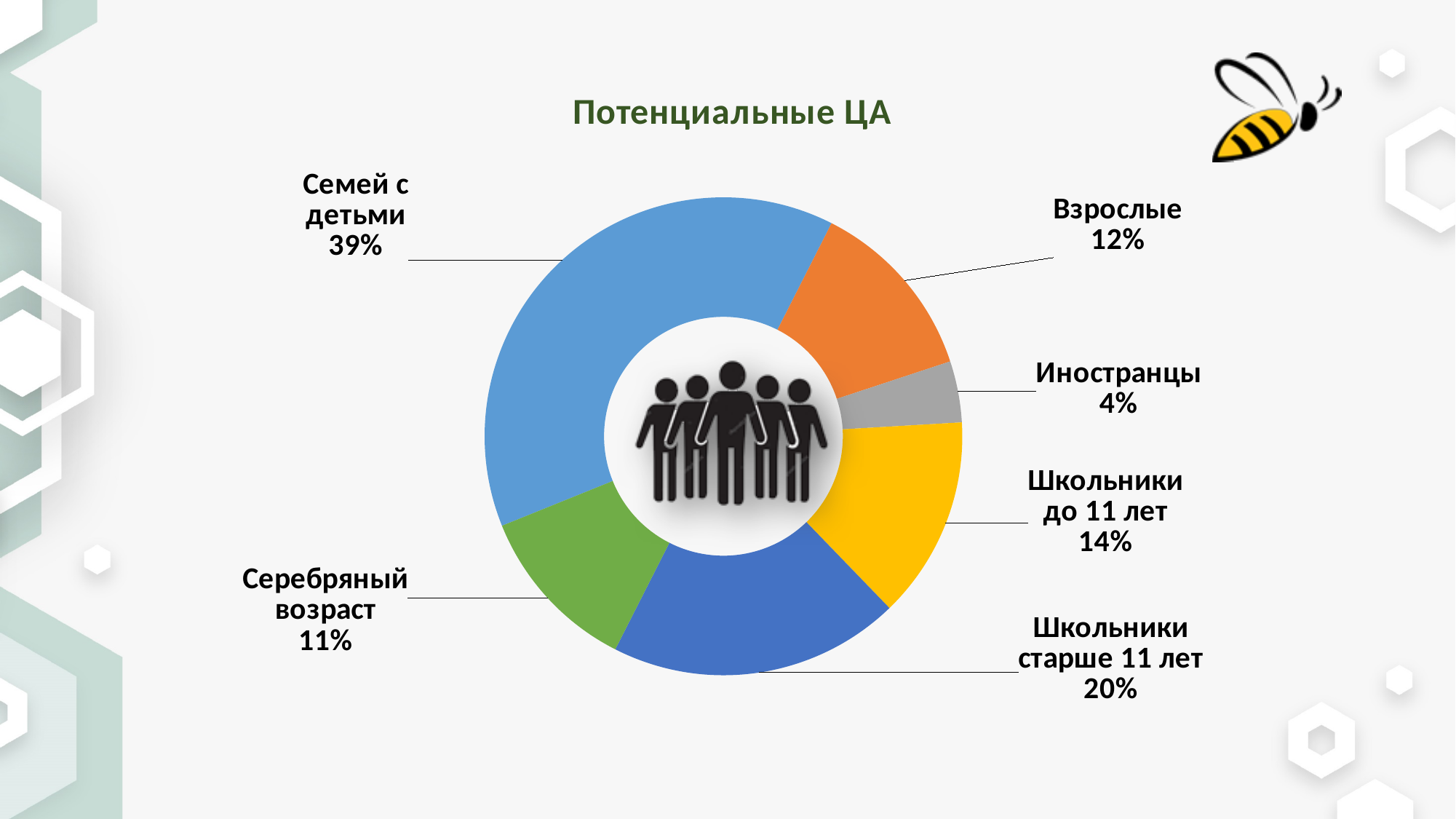
What kind of chart is shown on the slide? Doughnut (pie) chart Which category has the smallest share? Иностранцы Which category has the largest share? Семей с детьми What colour is the 'Школьники до 11 лет' slice? Yellow What share of the chart is 'Серебряный возраст'? 11% What share of the chart is 'Семей с детьми'? 39% How many categories does the chart show? 6 What is the difference in percentage points between 'Семей с детьми' and 'Школьники старше 11 лет'? 19 What share of the chart is 'Иностранцы'? 4% What share of the chart is 'Школьники старше 11 лет'? 20% Which is larger: 'Взрослые' or 'Школьники до 11 лет'? Школьники до 11 лет What is the title of the chart? Потенциальные ЦА